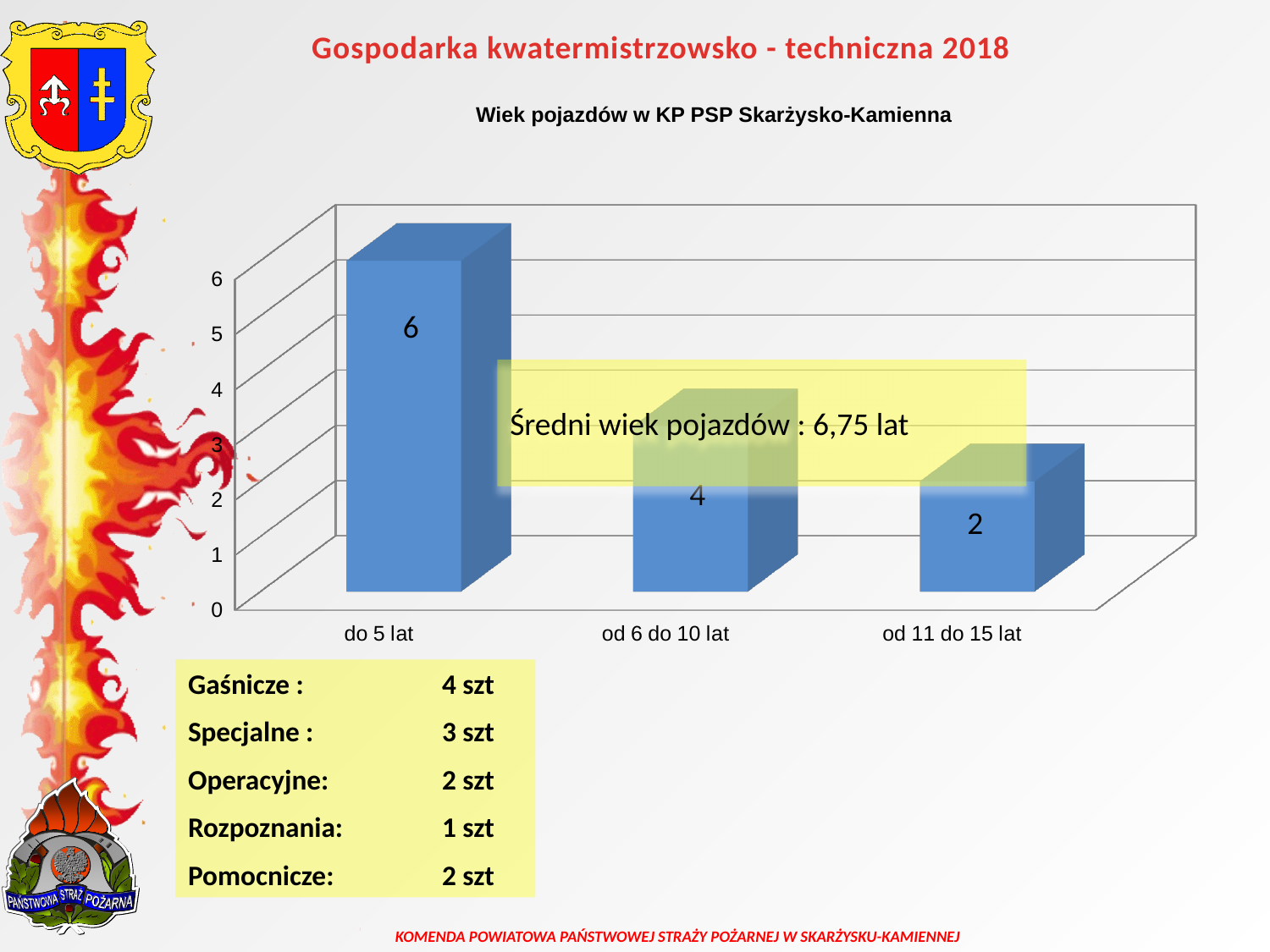
What is the value for the 'od 11 do 15 lat' category? 2 What is the difference between the values for 'do 5 lat' and 'od 11 do 15 lat'? 4 What is the title of the chart? Wiek pojazdów w KP PSP Skarżysko-Kamienna What kind of chart is shown on the slide? bar chart What is the value for the 'od 6 do 10 lat' category? 4 Which is larger, the value for 'od 6 do 10 lat' or 'od 11 do 15 lat'? od 6 do 10 lat Do the values rise or fall from left to right along the x axis? fall What is the difference between the values for 'do 5 lat' and 'od 6 do 10 lat'? 2 Which category has the lowest value? od 11 do 15 lat Which category has the highest value? do 5 lat What is the value for the 'do 5 lat' category? 6 How many categories are shown on the x axis? 3